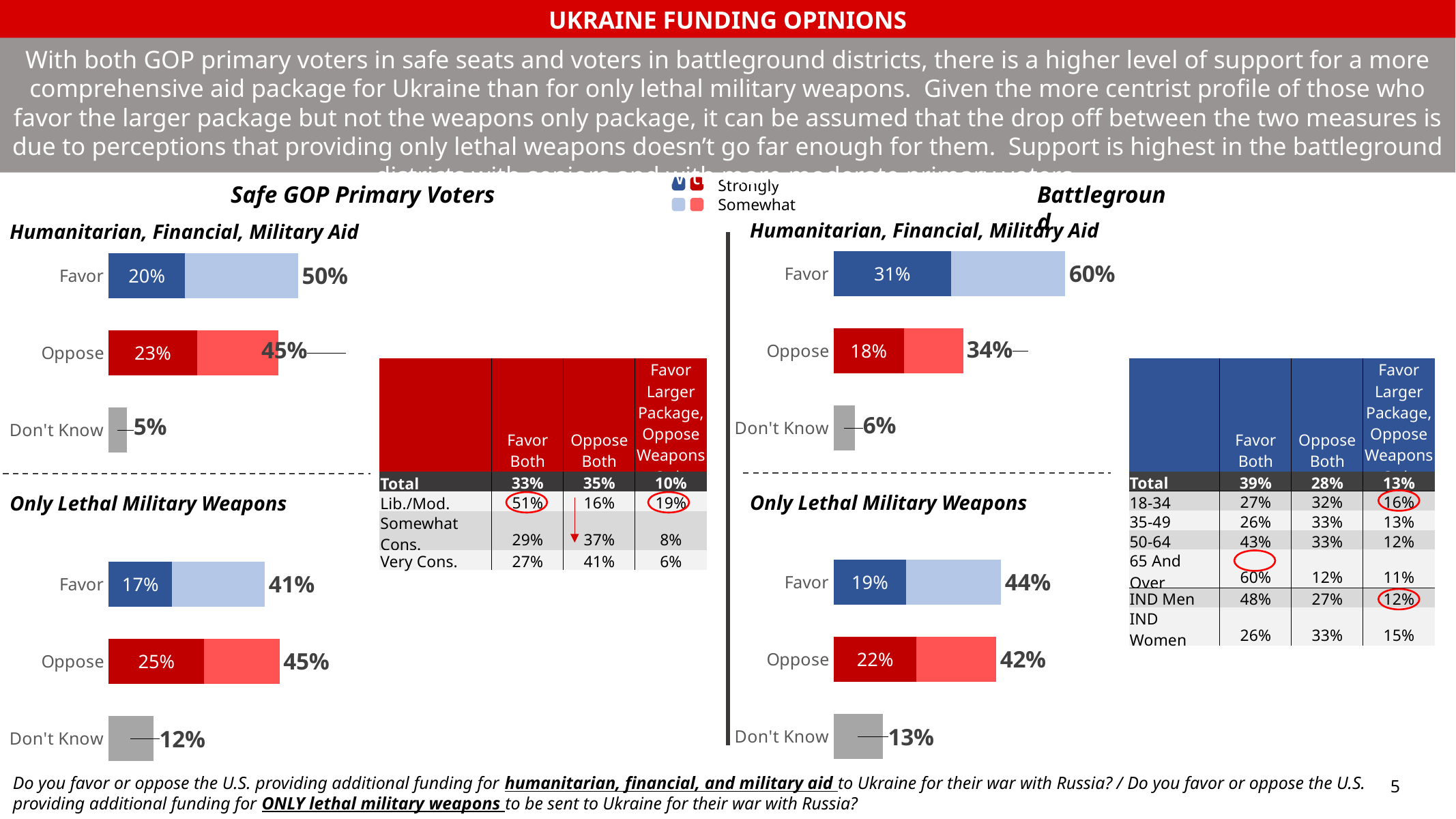
In the Safe GOP Primary Voters 'Only Lethal Military Weapons' chart, what is the Don't Know value? 12% How many categories are shown in the Battleground 'Only Lethal Military Weapons' chart? 3 In the Safe GOP Primary Voters 'Only Lethal Military Weapons' chart, which category has the lowest value? Don't Know In the Safe GOP Primary Voters 'Humanitarian, Financial, Military Aid' chart, what is the Strongly Favor value? 20% In the Safe GOP Primary Voters 'Humanitarian, Financial, Military Aid' chart, what is the total Favor value? 50% In the Safe GOP Primary Voters 'Only Lethal Military Weapons' chart, which is larger, the total Favor or the total Oppose value? Oppose In the Battleground 'Humanitarian, Financial, Military Aid' chart, which category has the highest total value? Favor In the Battleground 'Only Lethal Military Weapons' chart, what is the Strongly Oppose value? 22% In the Battleground 'Humanitarian, Financial, Military Aid' chart, what is the difference between the total Favor and total Oppose values? 26% What type of chart is the Safe GOP Primary Voters 'Humanitarian, Financial, Military Aid' chart? Bar chart How many entries does the legend at the top of the slide list? 2 In the Battleground 'Humanitarian, Financial, Military Aid' chart, what is the total Oppose value? 34%